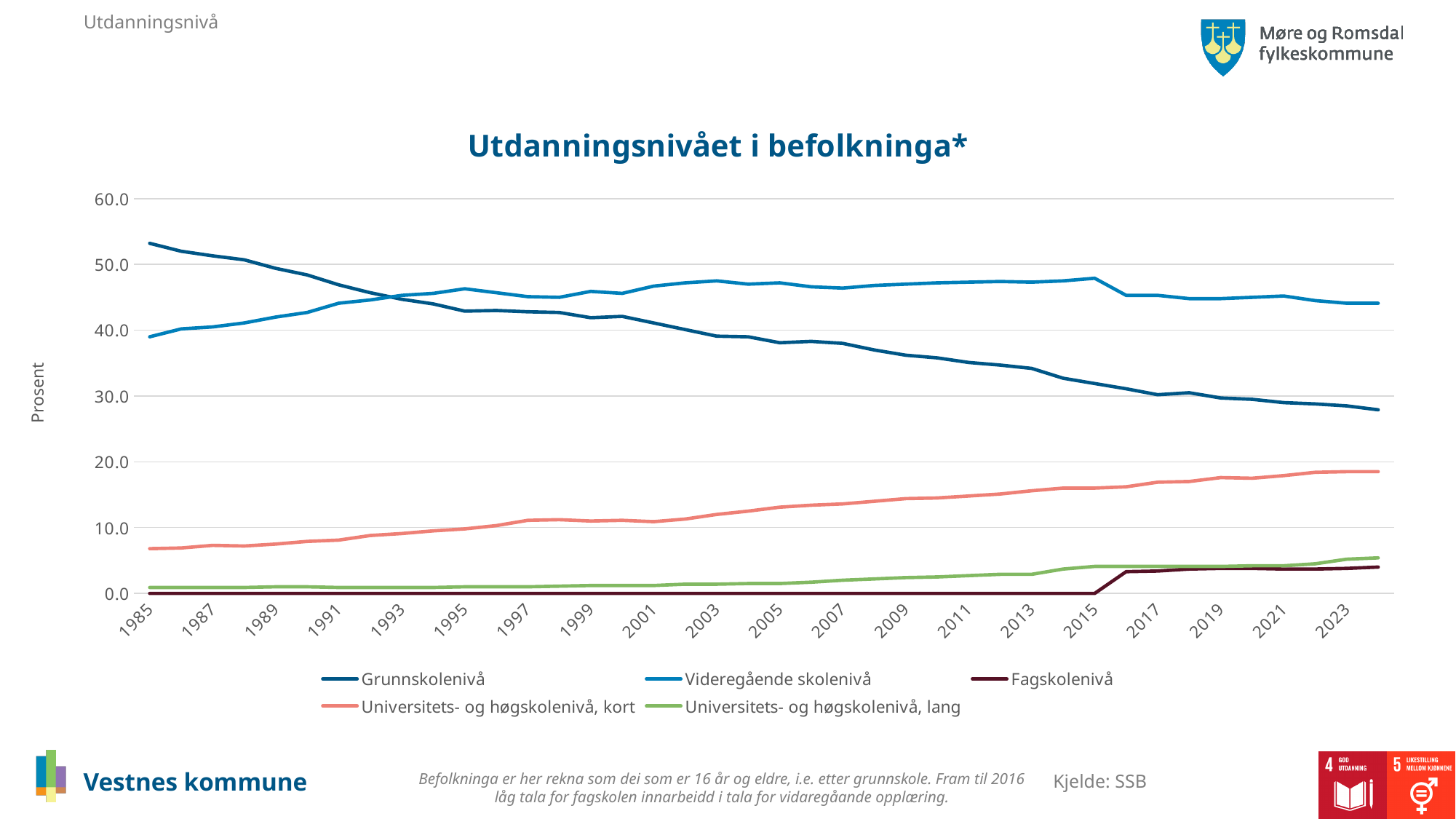
Is the value for Videregående skolenivå in 1985 greater or less than 40.0? less Does the Grunnskolenivå line rise or fall from 1985 to 2023? fall Is the value for Grunnskolenivå in 2023 greater or less than 30.0? less Is the value for Grunnskolenivå in 1985 greater or less than 50.0? greater What is the label on the vertical axis of the chart? Prosent How many series does the legend list? 5 What kind of chart is shown on the slide? line chart What is the title of the chart? Utdanningsnivået i befolkninga* Which series has the highest value in 2023? Videregående skolenivå In 1985, which is larger: Grunnskolenivå or Videregående skolenivå? Grunnskolenivå Does the Universitets- og høgskolenivå, kort line rise or fall from 1985 to 2023? rise